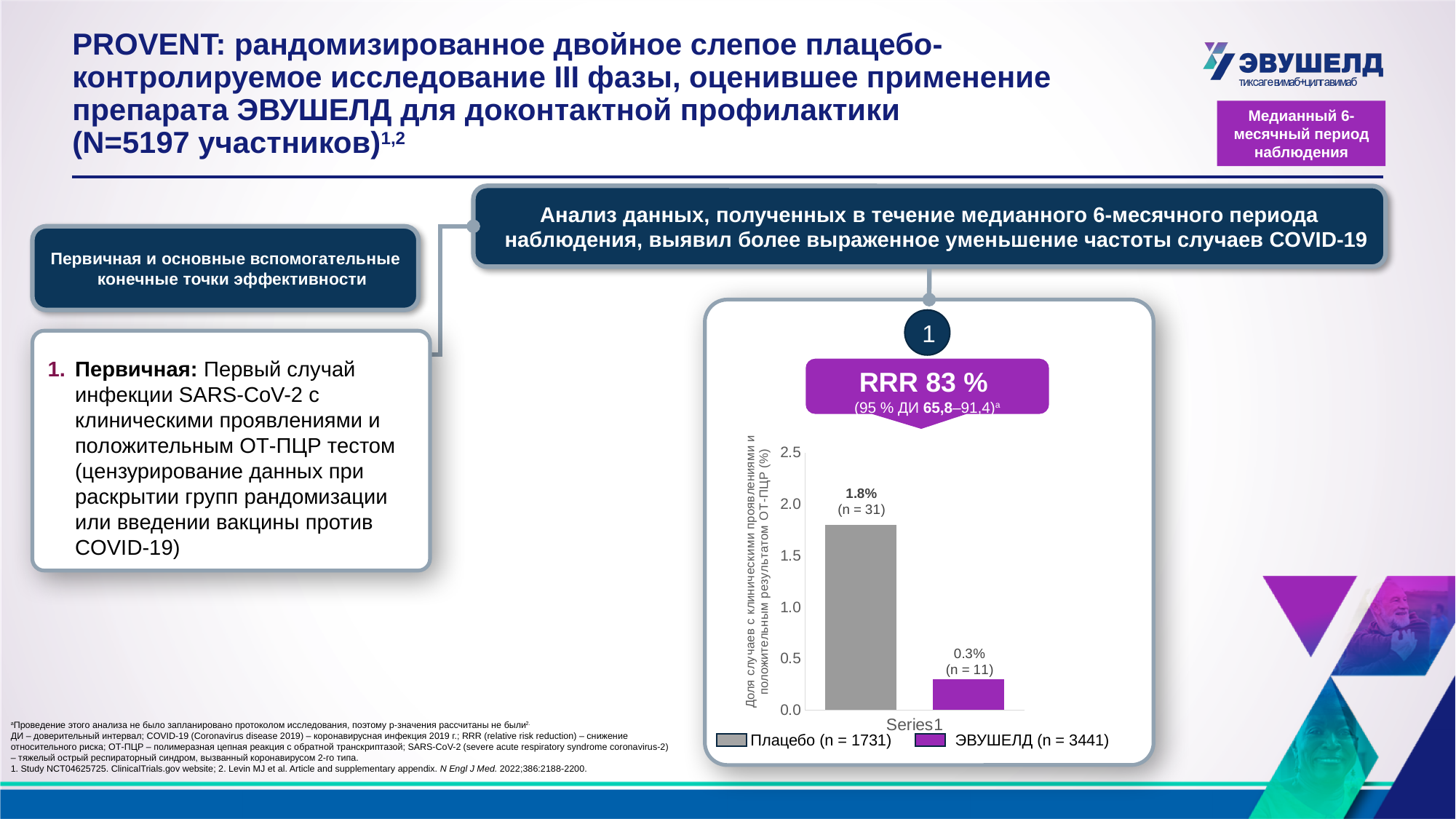
What is the value shown for the Плацебо (placebo) bar? 1.8% How many bars are plotted in the chart? 2 Is the value for Плацебо greater or less than 1.5? greater How many series does the legend list? 2 What is the value shown for the ЭВУШЕЛД bar? 0.3% Which group has the higher bar, Плацебо or ЭВУШЕЛД? Плацебо Which group has the lowest value in the chart? ЭВУШЕЛД What kind of chart is shown on the slide? Bar chart What is the maximum value shown on the y-axis of the chart? 2.5 What is the number of cases (n) shown above the Плацебо bar? n = 31 What is the difference between the Плацебо value and the ЭВУШЕЛД value? 1.5% Is the value for ЭВУШЕЛД greater or less than 0.5? less